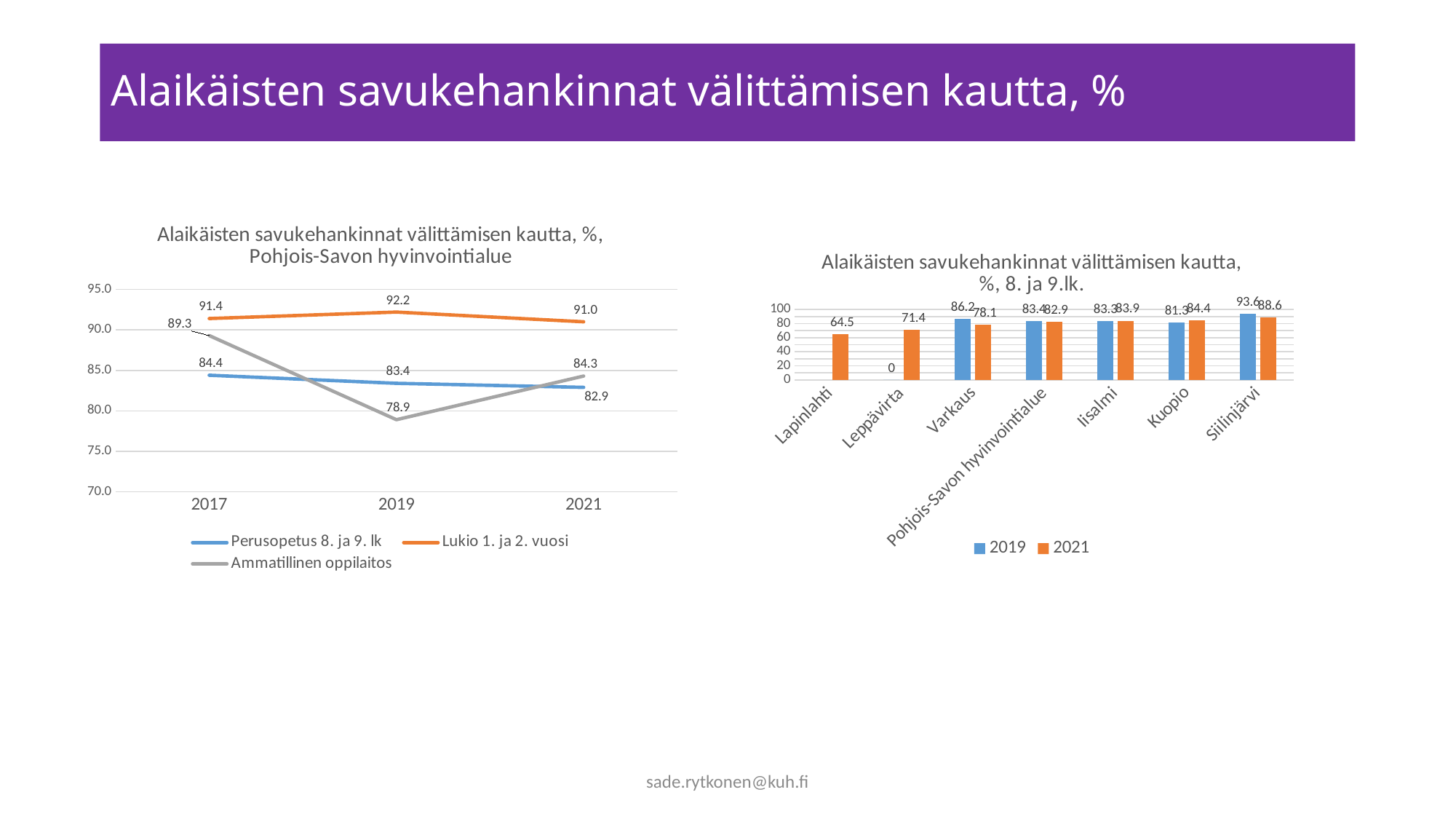
In the left chart (Pohjois-Savon hyvinvointialue), what is the difference between the Ammatillinen oppilaitos values in 2017 and 2019? 10.4 In the left chart (Pohjois-Savon hyvinvointialue), does the Perusopetus 8. ja 9. lk series rise or fall from 2017 to 2021? fall In the right chart (8. ja 9.lk.), what is the 2019 value for Varkaus? 86.2 In the right chart (8. ja 9.lk.), how many categories are shown on the x axis? 7 In the right chart (8. ja 9.lk.), what is the 2021 value for Lapinlahti? 64.5 In the left chart (Pohjois-Savon hyvinvointialue), what is the value for Perusopetus 8. ja 9. lk in 2021? 82.9 In the right chart (8. ja 9.lk.), which category has the highest 2019 value? Siilinjärvi What kind of chart is the right chart (8. ja 9.lk.)? bar chart In the left chart (Pohjois-Savon hyvinvointialue), which series has the highest value in 2017? Lukio 1. ja 2. vuosi How many series does the legend of the left chart (Pohjois-Savon hyvinvointialue) list? 3 In the left chart (Pohjois-Savon hyvinvointialue), what is the value for Ammatillinen oppilaitos in 2019? 78.9 In the left chart (Pohjois-Savon hyvinvointialue), what is the value for Lukio 1. ja 2. vuosi in 2019? 92.2